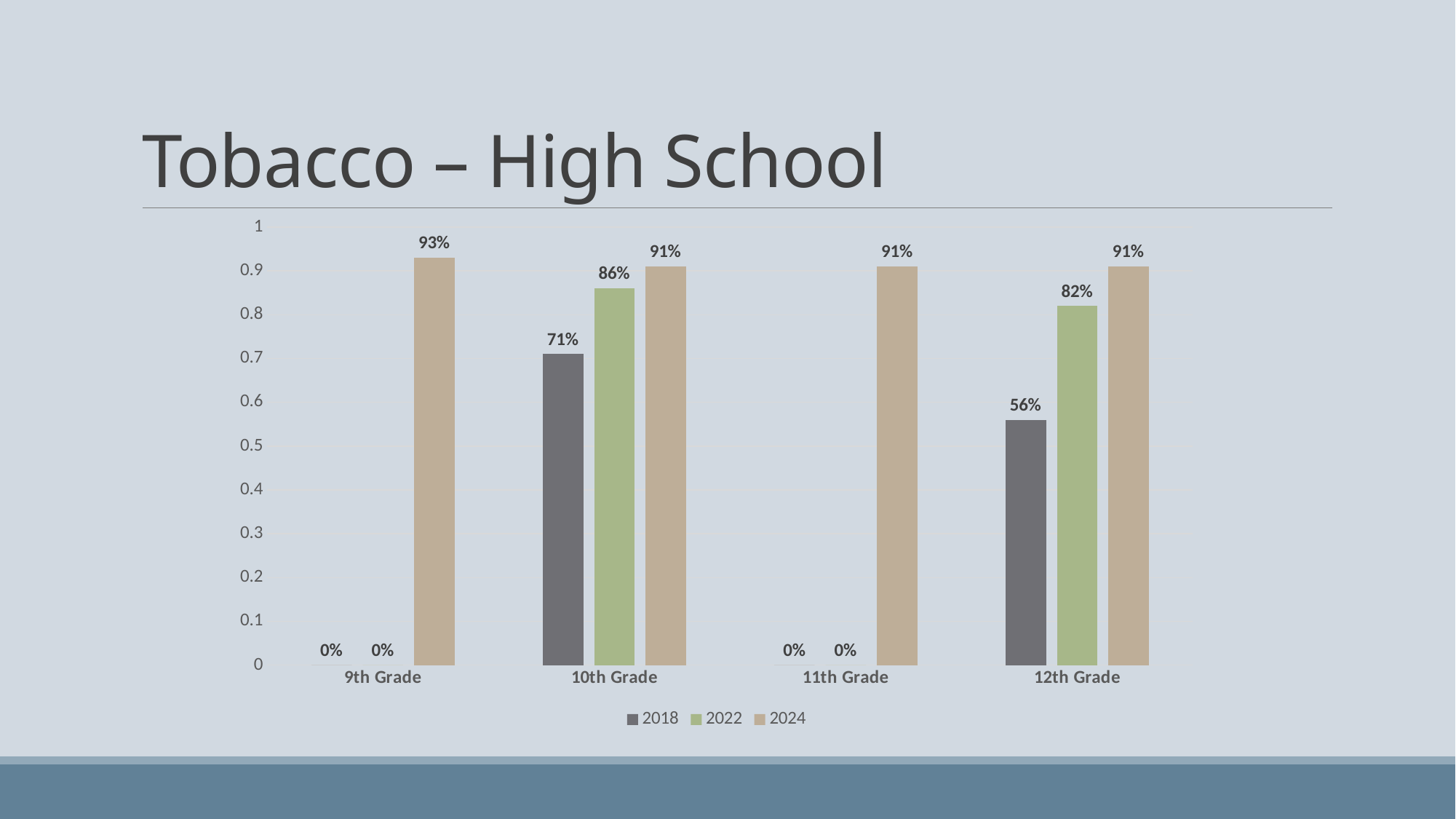
What is the 2018 value for 11th Grade? 0% What is the 2018 value for 10th Grade? 71% What is the difference between the 2022 and 2018 values for 12th Grade? 26% Which grade has the lowest 2022 value among those with a non-zero value? 12th Grade What is the title of the slide? Tobacco – High School What is the 2022 value for 12th Grade? 82% How many grade categories are shown on the x axis? 4 Which is larger for 10th Grade, the 2022 value or the 2018 value? 2022 What is the 2024 value for 9th Grade? 93% How many series does the legend list? 3 What kind of chart is shown on the slide? Bar chart Which grade has the highest 2024 value? 9th Grade